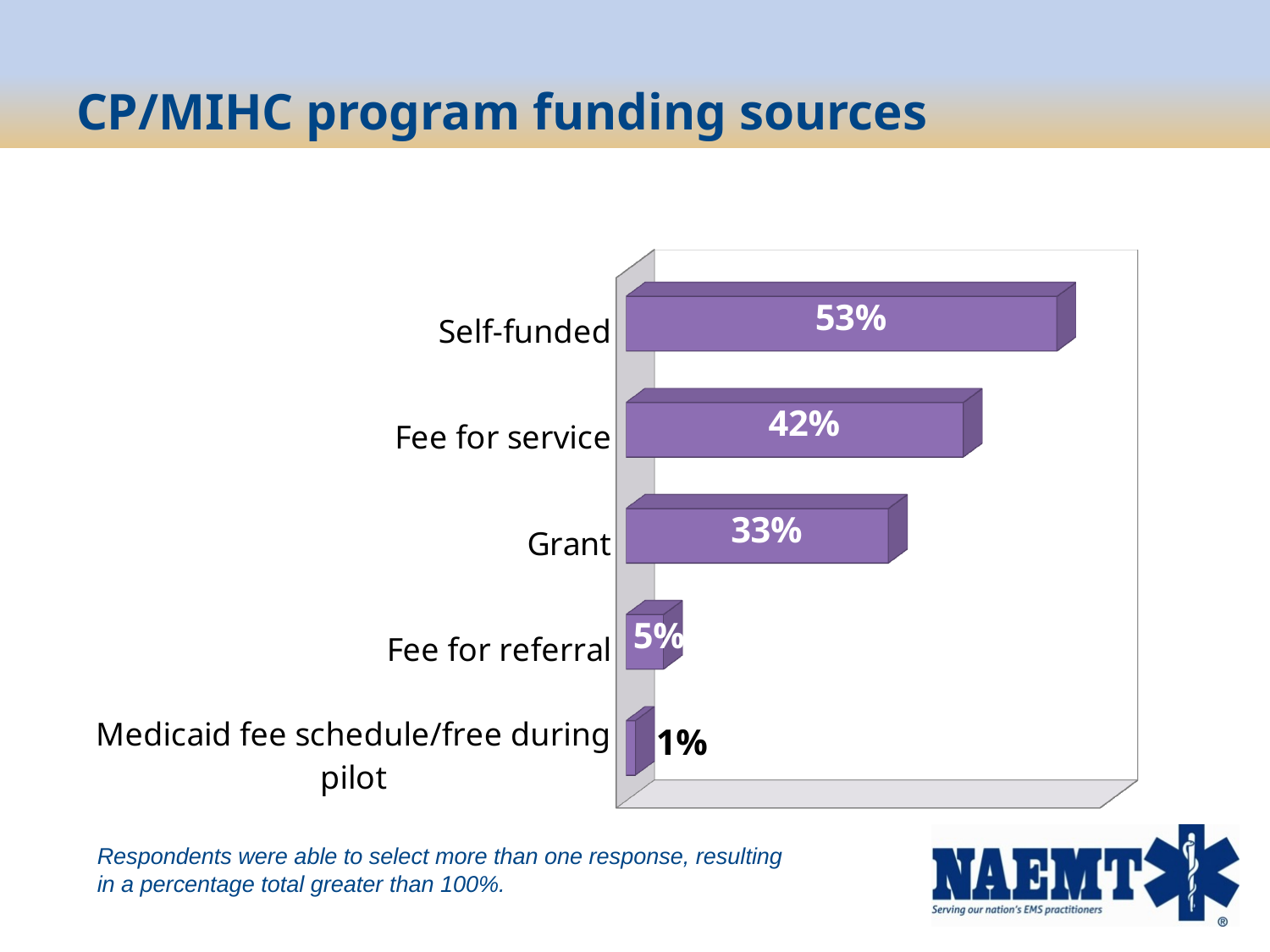
Which is larger, Fee for service or Grant? Fee for service What is the value for Fee for referral? 5% What percentage of programs reported being self-funded? 53% What is the value for Grant? 33% What is the value for Medicaid fee schedule/free during pilot? 1% What kind of chart is shown on the slide? Bar chart How many funding source categories are shown in the chart? 5 Which funding source has the highest percentage? Self-funded What is the difference between the Self-funded and Fee for service values? 11% What is the value for Fee for service? 42% What is the difference between the Grant and Fee for referral values? 28% Which funding source has the lowest percentage? Medicaid fee schedule/free during pilot